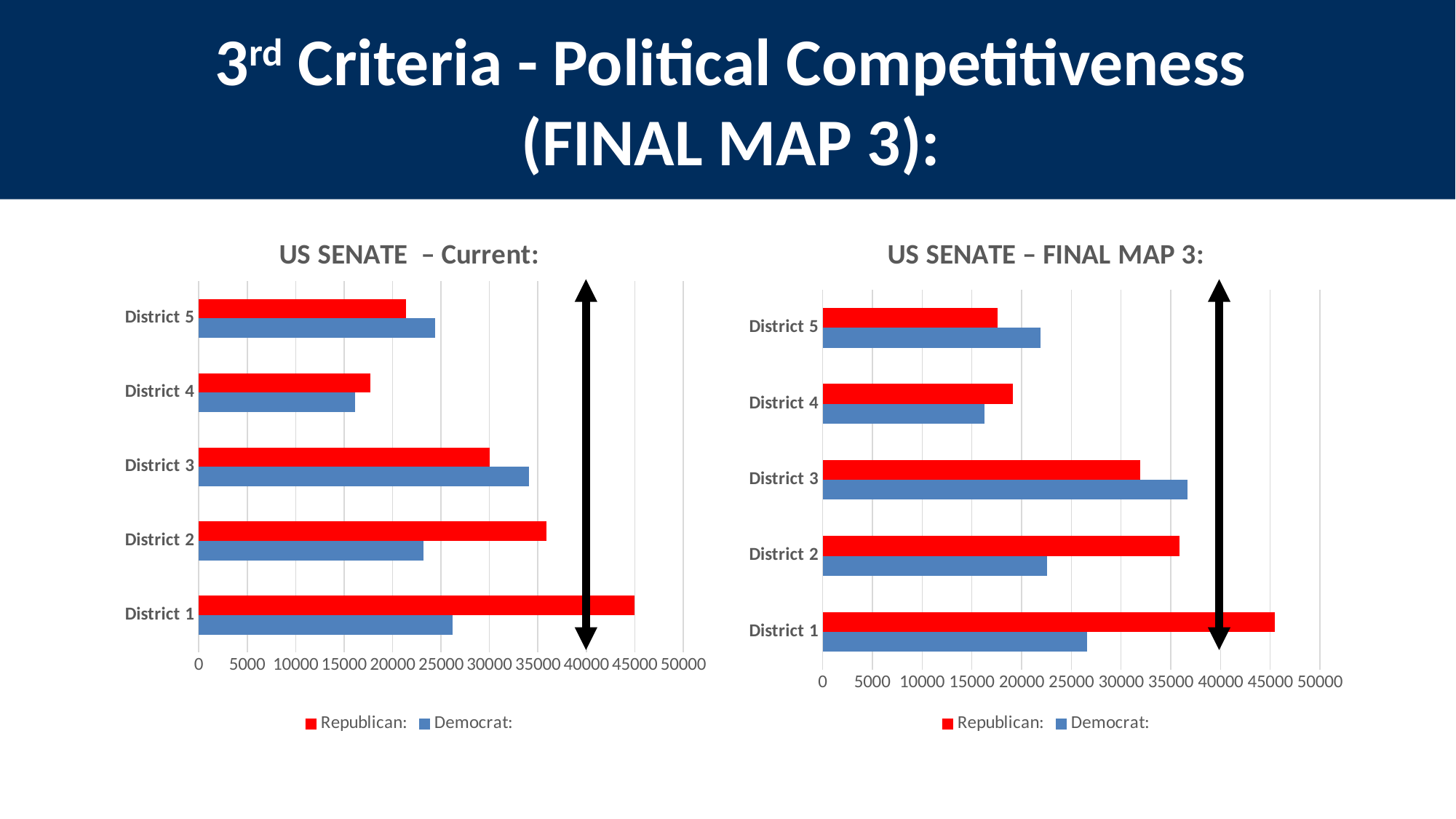
In the "US SENATE – FINAL MAP 3:" chart, which is larger for District 5, Republican or Democrat? Democrat How many series does the legend of the "US SENATE – FINAL MAP 3:" chart list? 2 How many districts are shown on the "US SENATE – Current:" chart? 5 In the "US SENATE – Current:" chart, which district has the highest Republican value? District 1 What colour represents the Democrat series in the "US SENATE – Current:" chart? blue In the "US SENATE – FINAL MAP 3:" chart, which district has the lowest Democrat value? District 4 In the "US SENATE – Current:" chart, which is larger for District 2, Republican or Democrat? Republican In the "US SENATE – Current:" chart, which district has the lowest Republican value? District 4 In the "US SENATE – FINAL MAP 3:" chart, which district has the highest Democrat value? District 3 In the "US SENATE – Current:" chart, is the Republican value for District 1 greater or less than 40000? greater In the "US SENATE – FINAL MAP 3:" chart, is the Democrat value for District 3 greater or less than 35000? greater What kind of chart is the "US SENATE – Current:" chart? bar chart